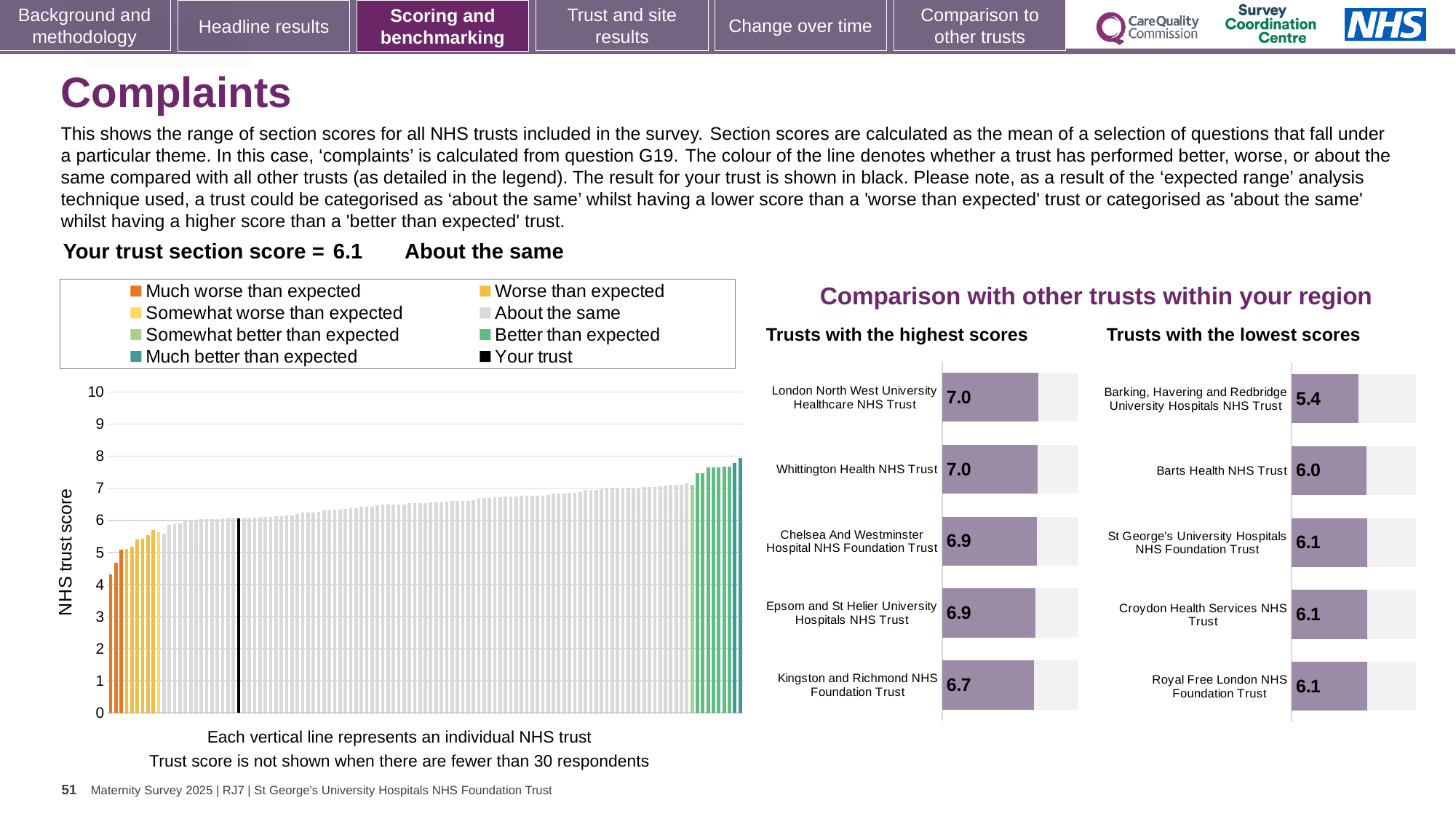
In the large chart on the left, is the value of the shortest bar greater or less than 5? less In the 'Trusts with the lowest scores' chart, what is the difference between the scores of Barts Health NHS Trust and Barking, Havering and Redbridge University Hospitals NHS Trust? 0.6 In the 'Trusts with the highest scores' chart, what is the score for Kingston and Richmond NHS Foundation Trust? 6.7 In the 'Trusts with the highest scores' chart, how many trusts are shown? 5 What kind of chart is the large chart on the left showing NHS trust scores? Bar chart In the large chart on the left, what is the label on the vertical axis? NHS trust score In the 'Trusts with the lowest scores' chart, which trust has the lowest score? Barking, Havering and Redbridge University Hospitals NHS Trust How many entries does the legend above the large chart on the left list? 8 In the 'Trusts with the lowest scores' chart, what is the score for Barts Health NHS Trust? 6.0 In the large chart on the left, do the bars rise or fall from left to right? Rise In the 'Trusts with the highest scores' chart, what is the difference between the scores of London North West University Healthcare NHS Trust and Kingston and Richmond NHS Foundation Trust? 0.3 In the large chart on the left, is the value of the tallest bar greater or less than 7? greater